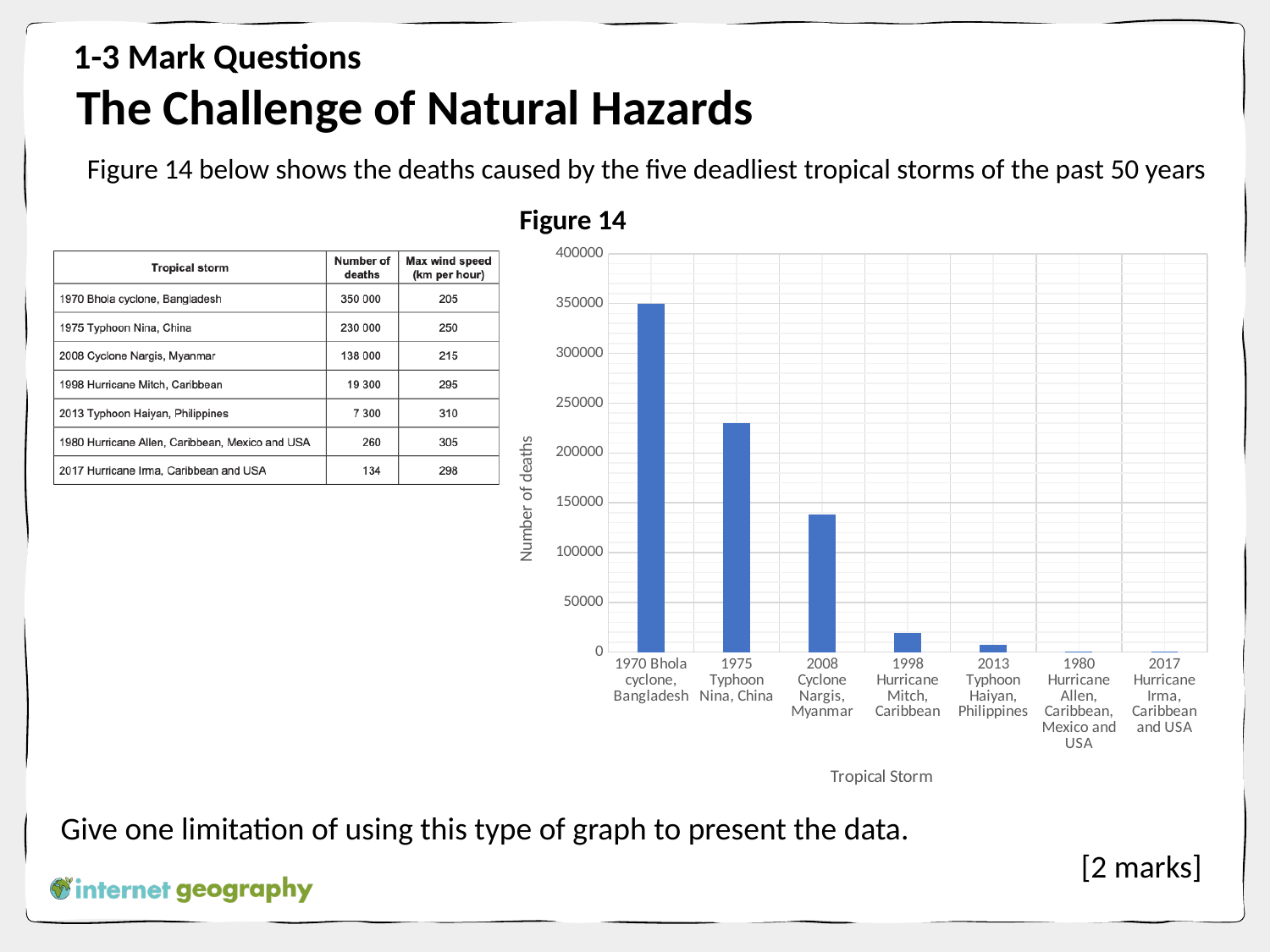
Using the values in the table, what is the difference in deaths between the 1970 Bhola cyclone and 1975 Typhoon Nina? 120 000 What is the label on the vertical axis of the chart? Number of deaths According to the table on the slide, how many deaths were caused by 1998 Hurricane Mitch, Caribbean? 19 300 Is the number of deaths for 1998 Hurricane Mitch, Caribbean greater or less than 50000? less Which tropical storm has the highest number of deaths in the chart? 1970 Bhola cyclone, Bangladesh Is the number of deaths for the 1970 Bhola cyclone, Bangladesh greater or less than 300000? greater Do the bar heights rise or fall from left to right along the x axis? fall How many tropical storms are plotted on the x axis of the chart? 7 Is the number of deaths for 1975 Typhoon Nina, China greater or less than 250000? less Which has more deaths: 1975 Typhoon Nina, China or 2008 Cyclone Nargis, Myanmar? 1975 Typhoon Nina, China What type of chart is shown in Figure 14? bar chart